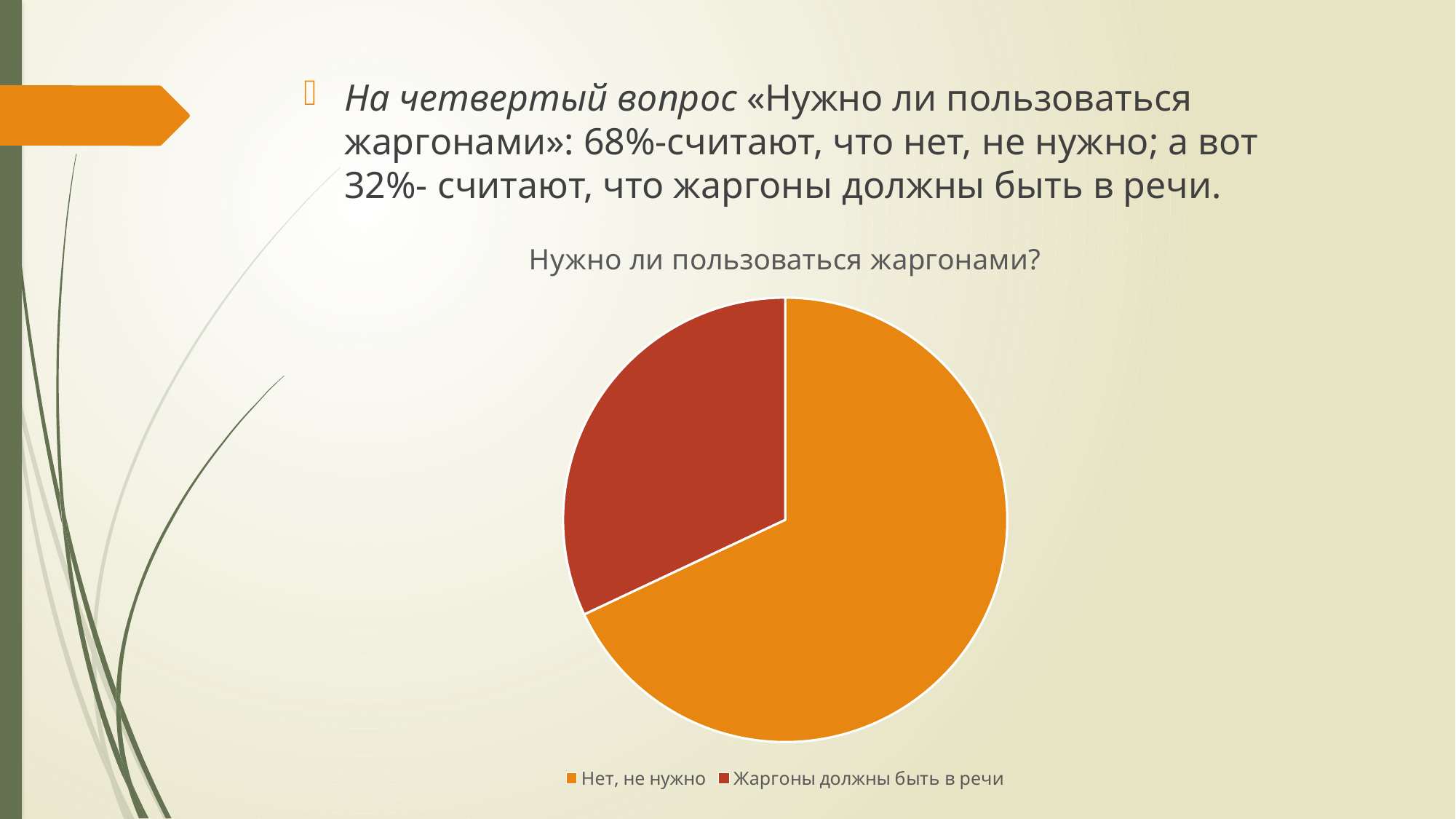
What share of the pie does "Жаргоны должны быть в речи" take, according to the slide? 32% How many slices does the pie chart have? 2 How many entries does the legend of the pie chart list? 2 By how many percentage points does "Нет, не нужно" exceed "Жаргоны должны быть в речи" on the slide? 36 What is the title of the pie chart? Нужно ли пользоваться жаргонами? What share of the pie does "Нет, не нужно" take, according to the slide? 68% Which is larger in the pie chart: "Нет, не нужно" or "Жаргоны должны быть в речи"? Нет, не нужно Which slice of the pie chart is the largest? Нет, не нужно What colour is the "Жаргоны должны быть в речи" slice in the pie chart? red Is the share for "Нет, не нужно" greater or less than half of the pie? greater What kind of chart is shown on the slide? pie chart Which slice of the pie chart is the smallest? Жаргоны должны быть в речи